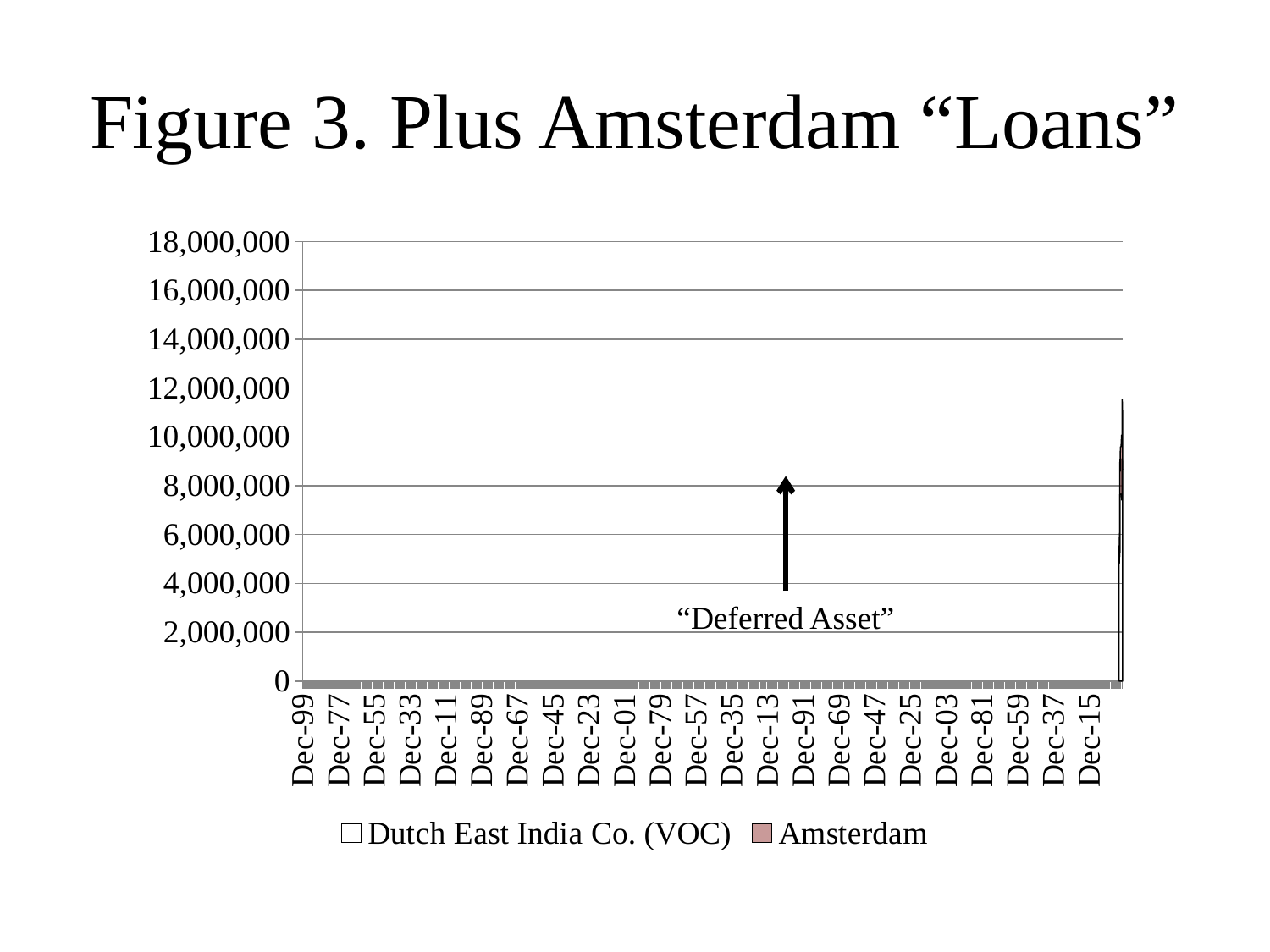
Is the highest value plotted on the chart greater or less than 12,000,000? less Where along the x axis does the large spike in values occur: at the left end, in the middle, or at the right end? at the right end What text does the arrow annotation on the chart point with? "Deferred Asset" What are the two series named in the legend? Dutch East India Co. (VOC) and Amsterdam How many series does the legend list? 2 Is the highest value plotted on the chart greater or less than 10,000,000? greater Across most of the x axis, are the plotted values near zero or near the top of the axis? near zero What kind of chart is shown on the slide? area chart